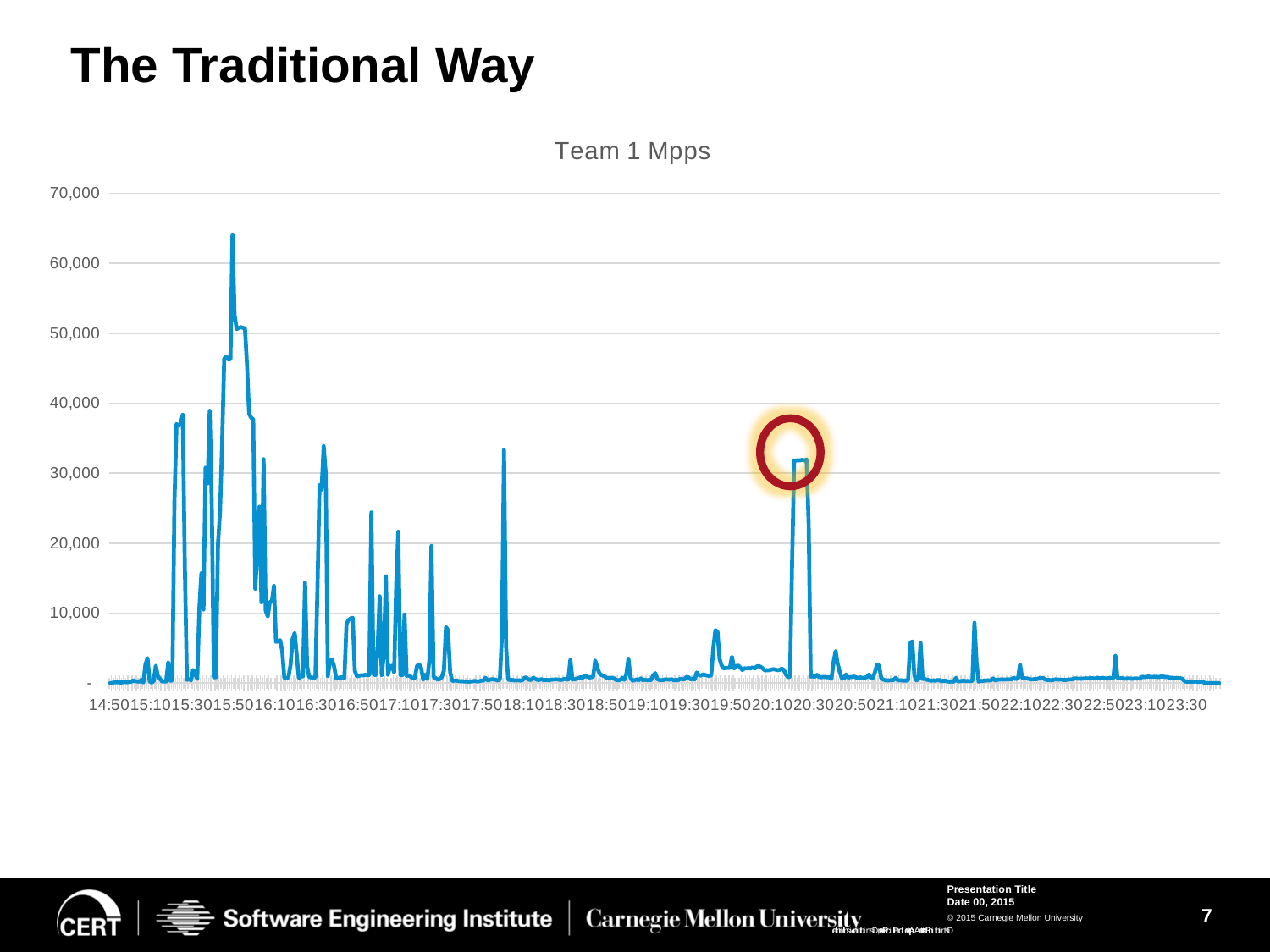
What is the title of the chart? Team 1 Mpps Is the value of the circled peak near 20:20 greater or less than 40,000? less What kind of chart is shown on the slide? line chart Is the spike near 18:10 greater or less than 40,000? less Do the values generally rise or fall from the left of the x axis to the right? fall Is the spike near 18:10 greater or less than 20,000? greater Around which time on the x axis does the line reach its highest value? 15:50 Which is larger: the peak near 15:50 or the circled peak near 20:20? the peak near 15:50 What is the highest value shown on the y axis? 70,000